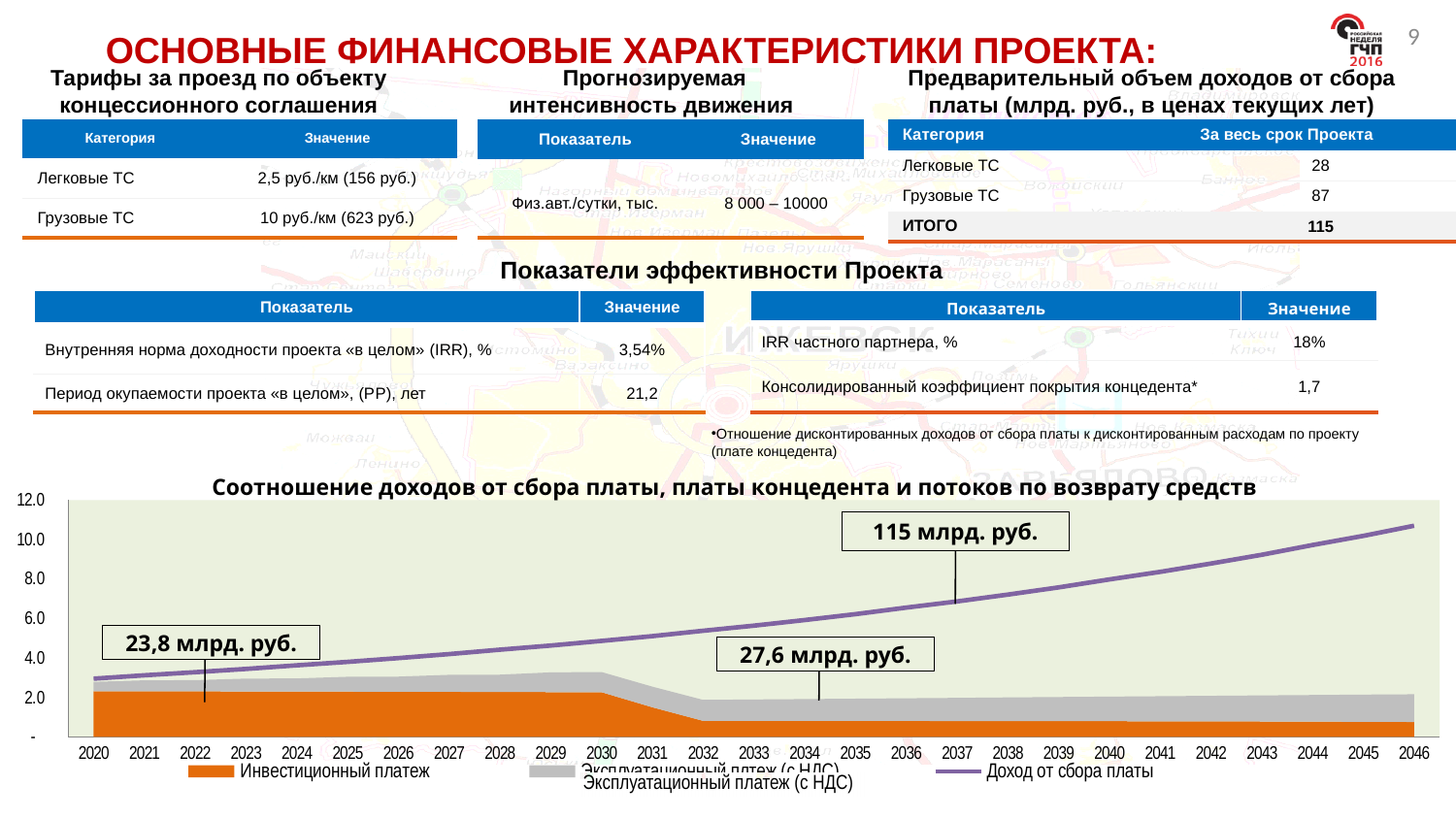
What value is shown in the callout pointing to the Доход от сбора платы line? 115 млрд. руб. Is the value of Инвестиционный платеж in 2025 greater or less than 4.0? less Is the value of Доход от сбора платы in 2046 greater or less than 10.0? greater What kind of chart is shown at the bottom of the slide? A combined stacked area and line chart What value is shown in the callout pointing to the Инвестиционный платеж area? 23,8 млрд. руб. Does the Инвестиционный платеж area rise or fall between 2029 and 2032? Fall Is the value of Доход от сбора платы in 2020 greater or less than 4.0? less In 2040, which is larger: Доход от сбора платы or Инвестиционный платеж? Доход от сбора платы How many series does the legend of the bottom chart list? 3 Does the line for Доход от сбора платы rise or fall from 2020 to 2046? Rise How many years are shown on the x axis of the bottom chart? 27